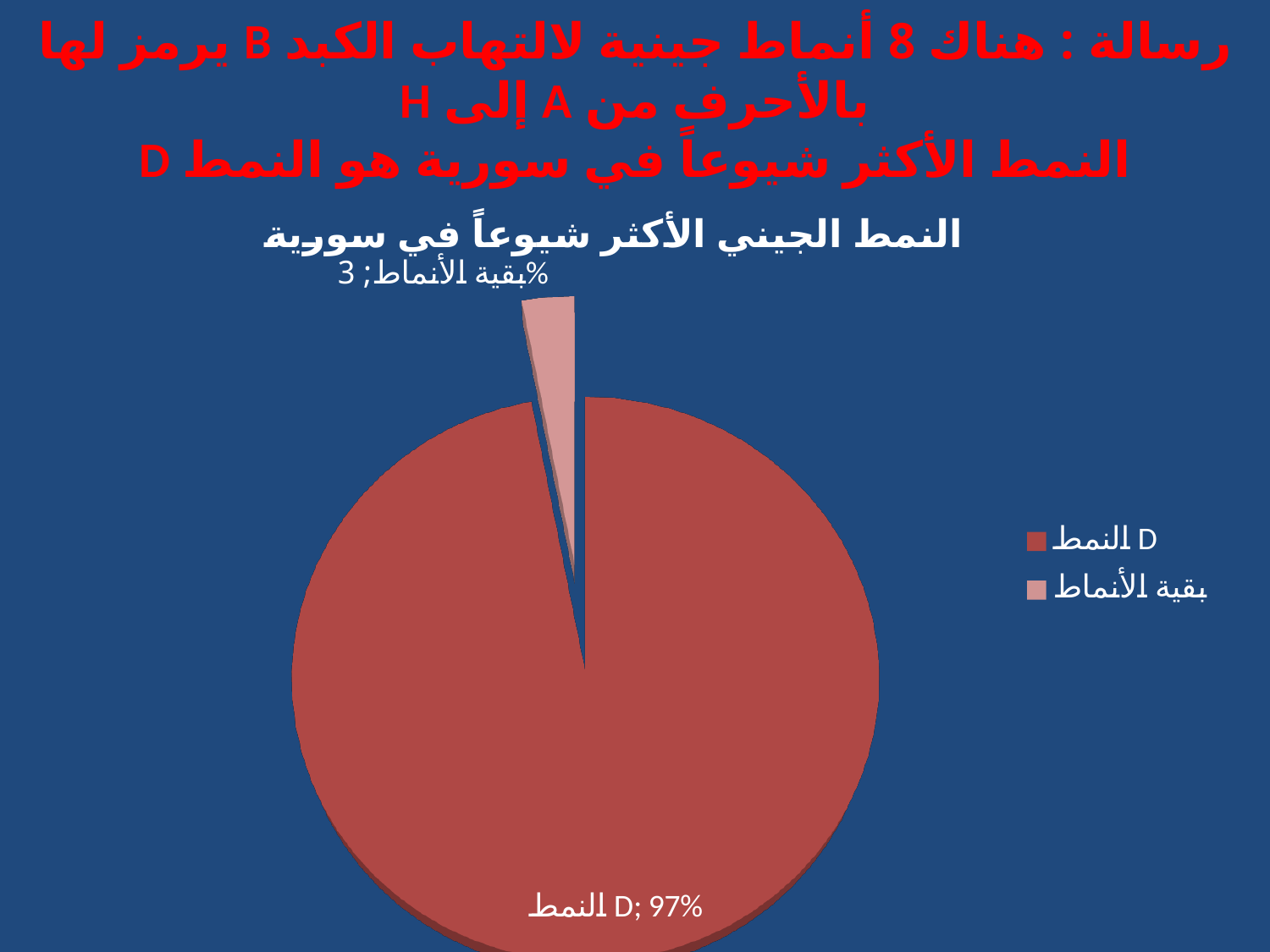
What is the value shown for النمط D? 97% What is the value shown for بقية الأنماط? 3% How many slices does the pie chart have? 2 Which legend entry is shown in the lighter pink colour? بقية الأنماط What is the difference between the values for النمط D and بقية الأنماط? 94% Which slice of the pie is the smallest? بقية الأنماط What is the title of the chart? النمط الجيني الأكثر شيوعاً في سورية Which slice of the pie is the largest? النمط D How many entries does the legend list? 2 What share of the pie does النمط D take? 97% What kind of chart is shown on the slide? pie chart Which is larger, the value for النمط D or the value for بقية الأنماط? النمط D